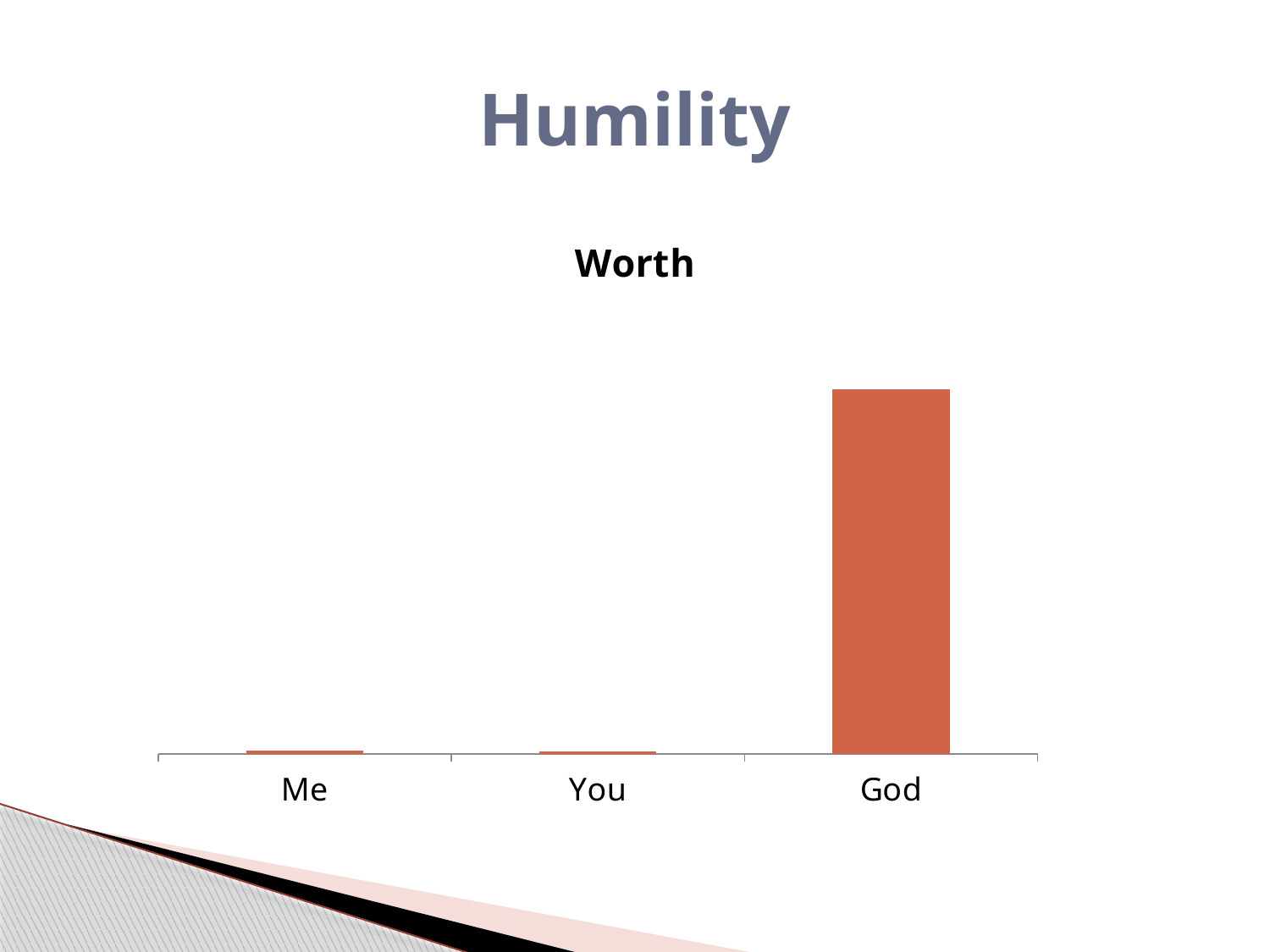
What kind of chart is shown on the slide? bar chart What are the category labels on the x axis of the chart, from left to right? Me, You, God Which is larger in the chart, the bar for God or the bar for Me? God Which is larger in the chart, the bar for God or the bar for You? God Which category has the highest bar in the chart? God How many categories are shown on the x axis of the chart? 3 What is the title of the chart? Worth